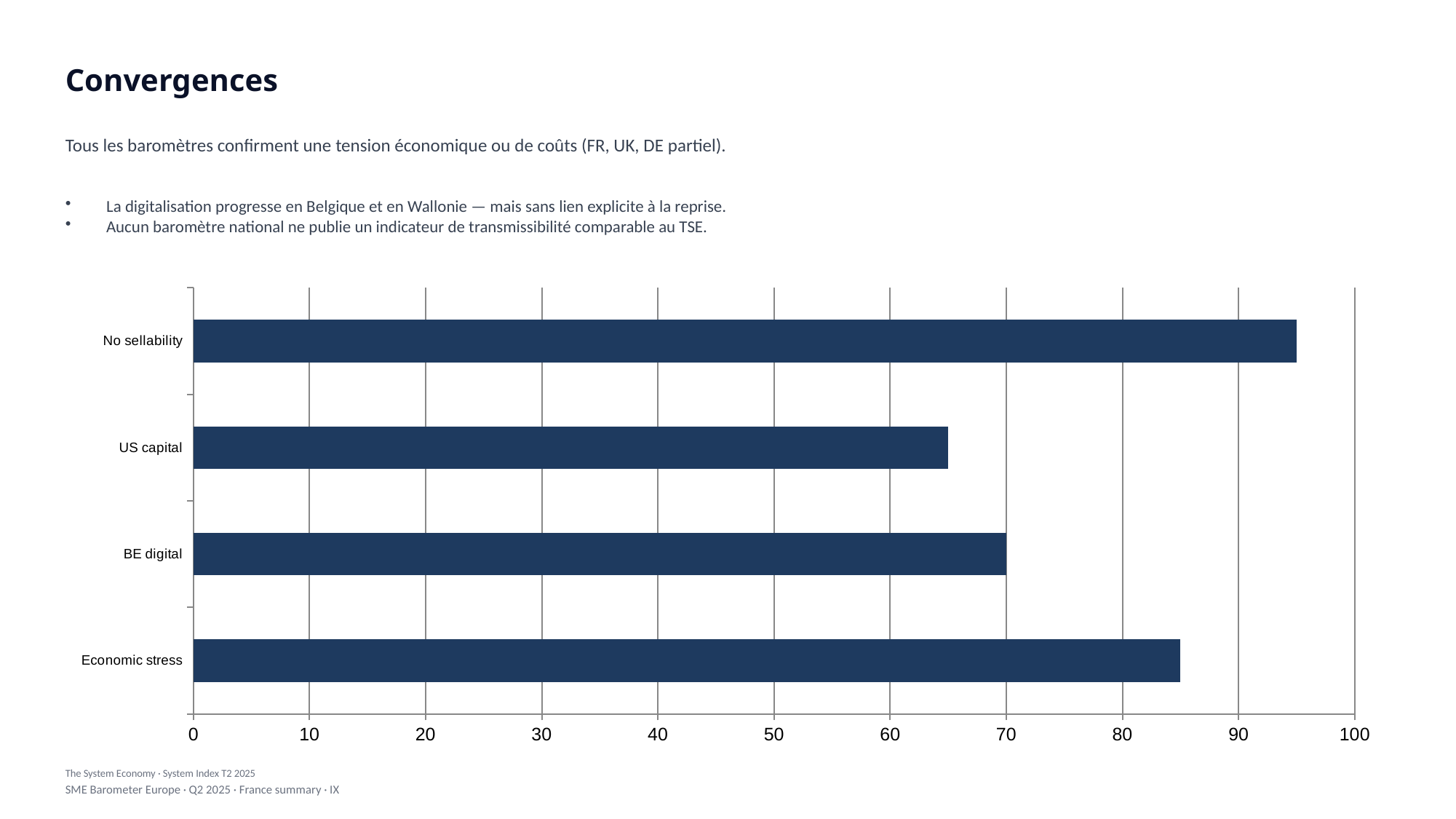
Which is larger, the value for US capital or the value for No sellability? No sellability Is the value for Economic stress greater or less than 90? less What is the maximum value shown on the horizontal axis of the chart? 100 Which category has the highest value in the chart? No sellability How many categories are plotted in the chart? 4 Is the value for No sellability greater or less than 90? greater Which category has the lowest value in the chart? US capital What is the value for BE digital? 70 Which is larger, the value for Economic stress or the value for BE digital? Economic stress What type of chart is shown on the slide? Bar chart Is the value for Economic stress greater or less than 80? greater